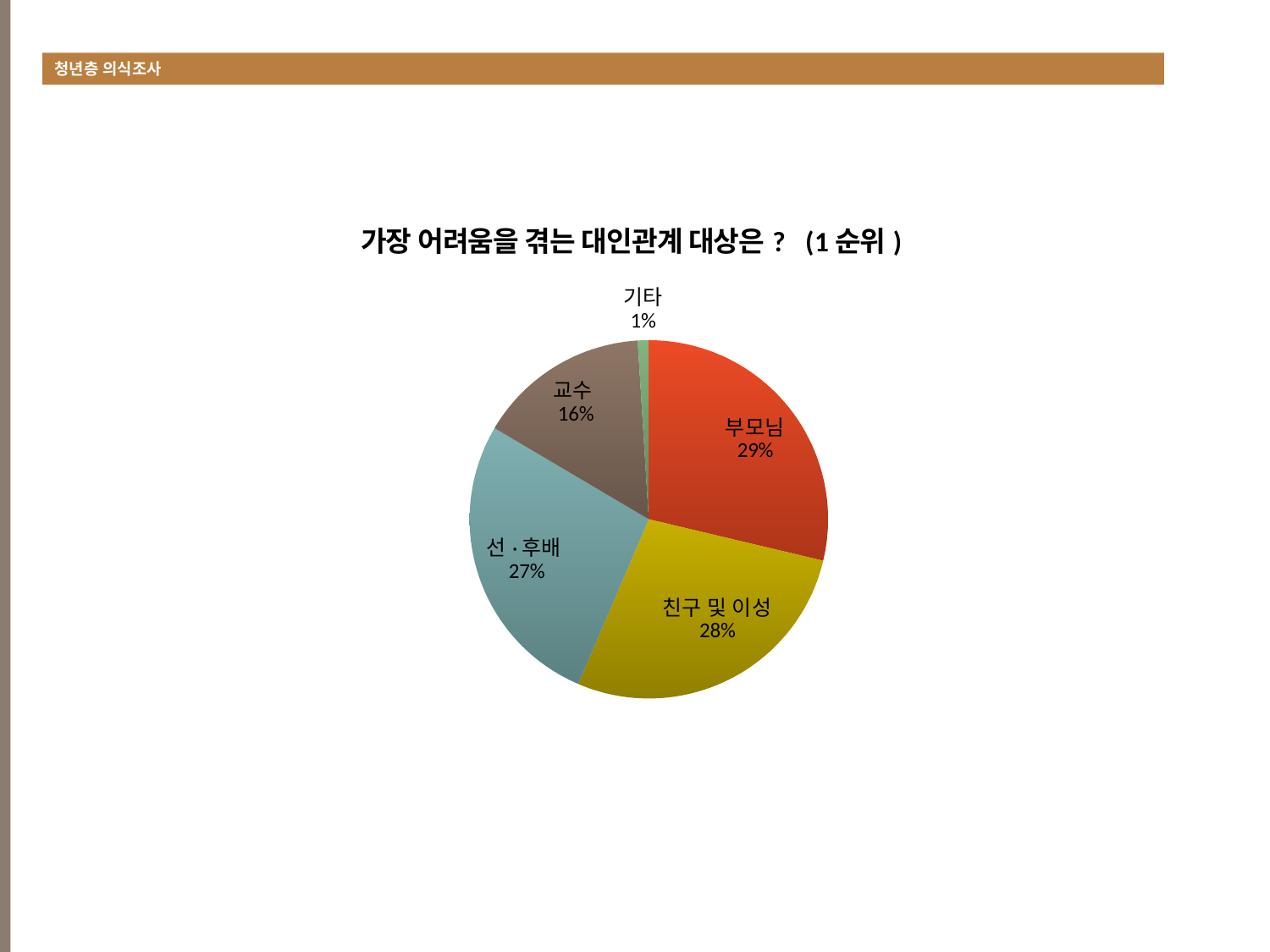
Which is larger, the share for 교수 or the share for 선·후배? 선·후배 What percentage is shown for 친구 및 이성? 28% What is the difference in percentage points between 부모님 and 교수? 13 What is the title of the chart? 가장 어려움을 겪는 대인관계 대상은 ? (1 순위 ) How many slices does the pie chart have? 5 What type of chart is shown on the slide? pie chart What percentage is shown for 기타? 1% What percentage is shown for 선·후배? 27% What percentage is shown for 부모님? 29% Which category has the largest share of the pie? 부모님 What percentage is shown for 교수? 16% Which category has the smallest share of the pie? 기타